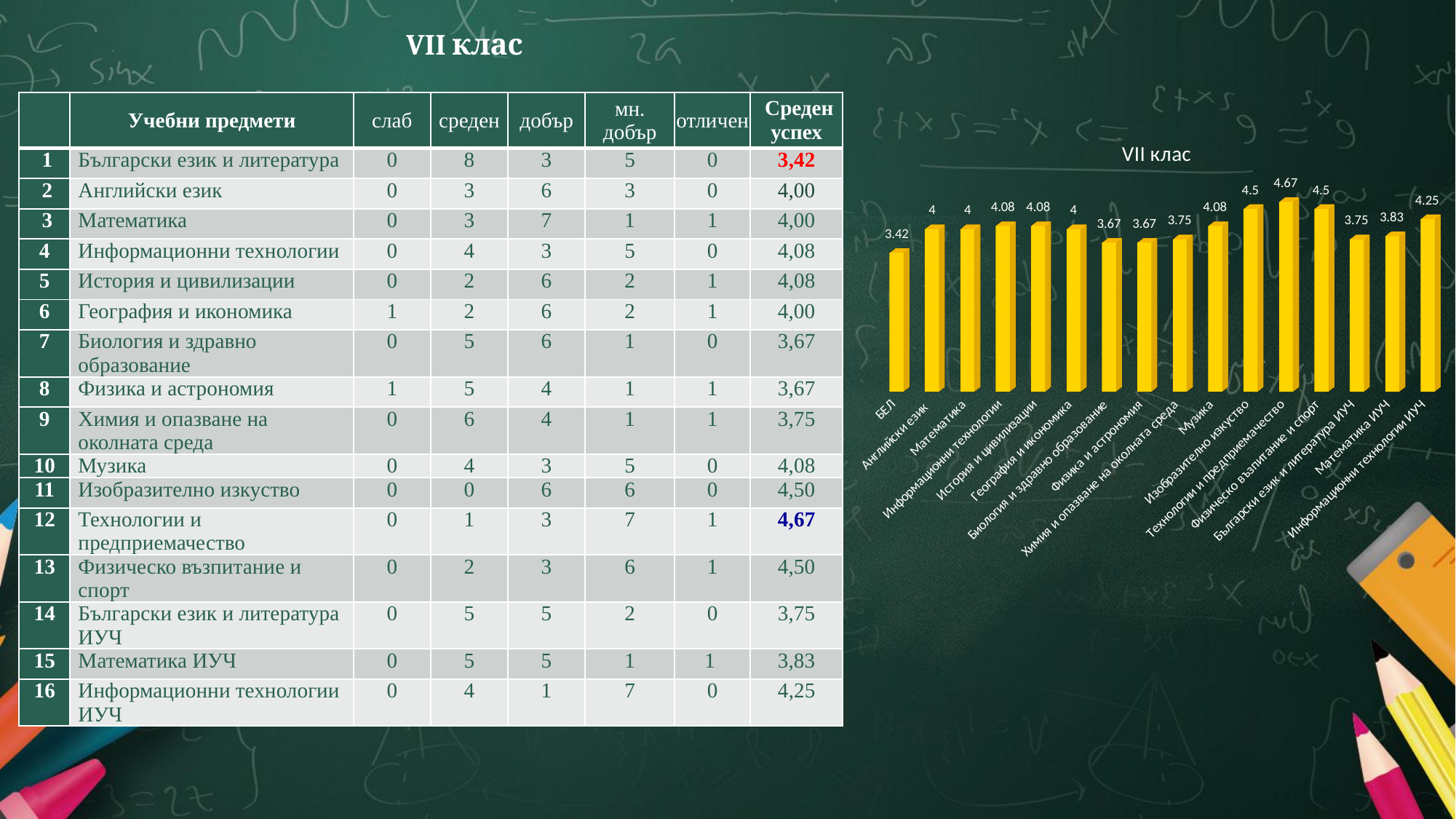
Which category has the highest value in the chart? Технологии и предприемачество What is the value for Математика ИУЧ in the chart? 3.83 What is the value for БЕЛ in the chart? 3.42 What is the value for Технологии и предприемачество in the chart? 4.67 What is the difference between the values for Технологии и предприемачество and БЕЛ? 1.25 What kind of chart is shown on the slide? bar chart What is the title of the chart? VII клас Which is larger, the value for Музика or the value for Физика и астрономия? Музика How many bars does the chart have? 16 What is the difference between the values for Изобразително изкуство and Химия и опазване на околната среда? 0.75 Which category has the lowest value in the chart? БЕЛ What is the value for Информационни технологии ИУЧ in the chart? 4.25